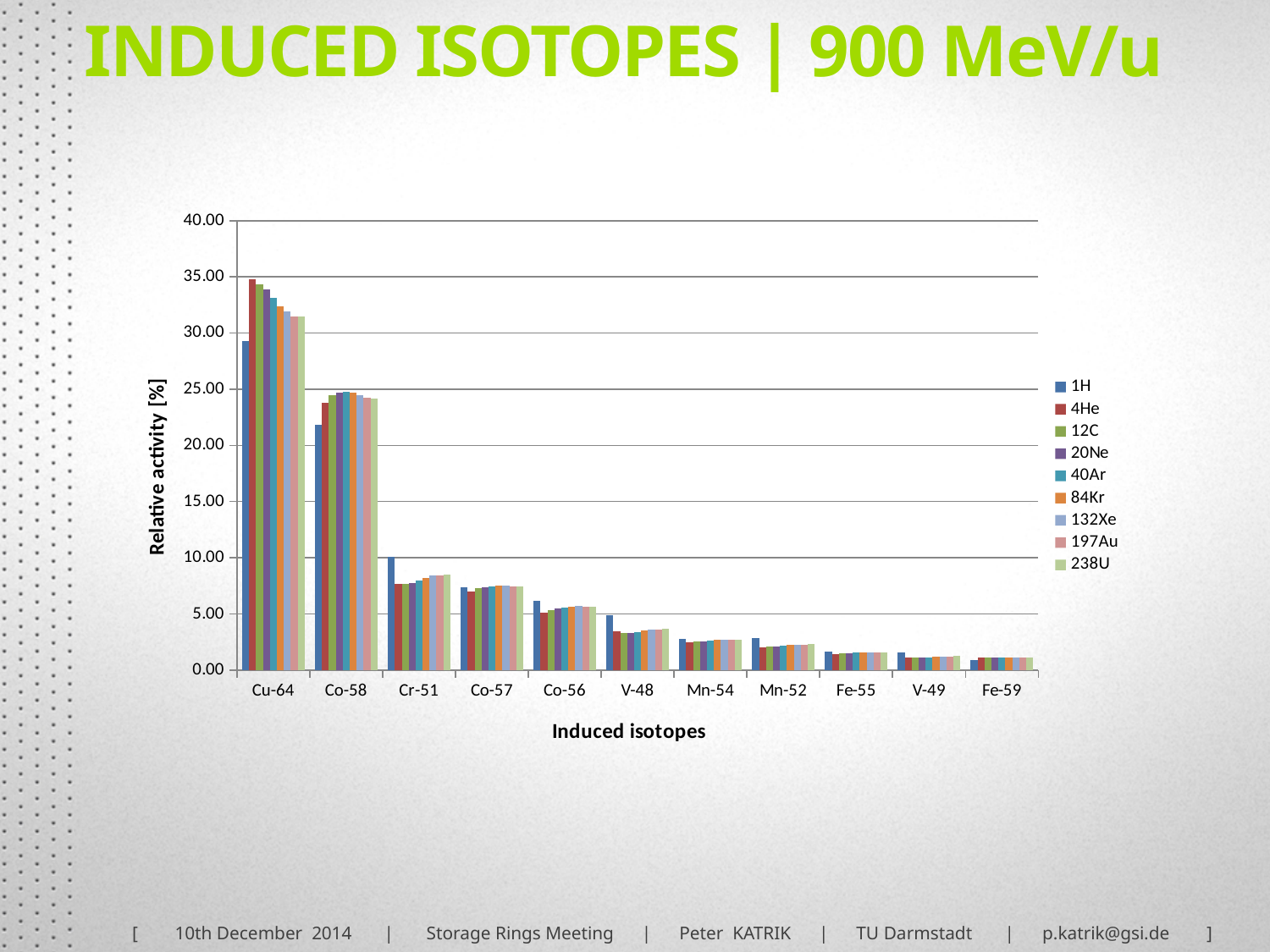
How many series does the legend list? 9 What kind of chart is shown on the slide? bar chart Which induced isotope has the highest relative activity? Cu-64 How many induced isotopes (categories) are shown on the x axis? 11 Is the relative activity of the 4He series for Cr-51 greater or less than 10.00? less For the 1H series, which has the larger relative activity: Cu-64 or Co-58? Cu-64 Is the relative activity of the 1H series for Cu-64 greater or less than 25.00? greater Do the relative activity values generally rise or fall moving from left to right along the x axis? fall What is the title of the y axis? Relative activity [%] Is the relative activity of the 1H series for Mn-54 greater or less than 5.00? less